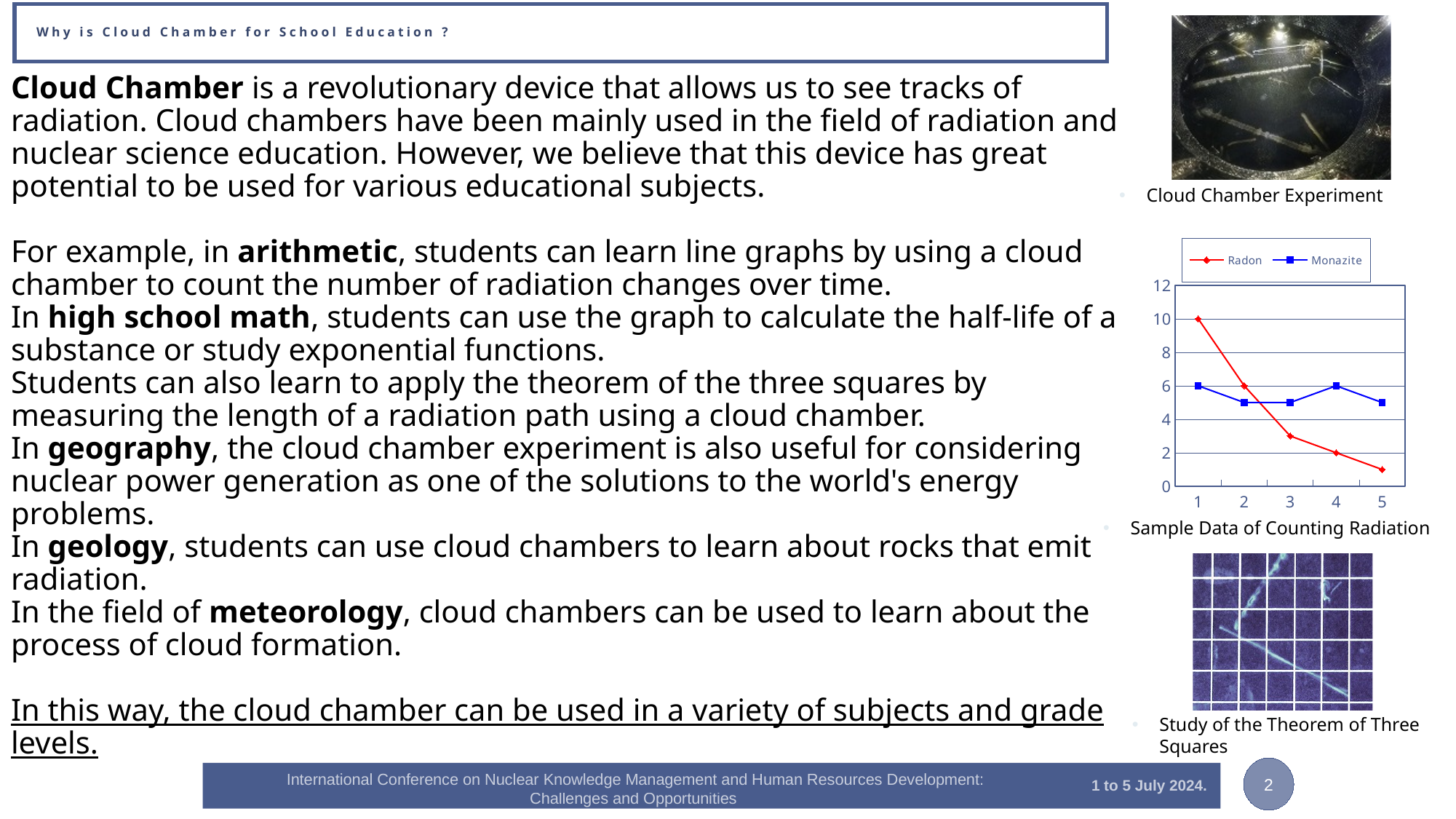
At x = 5, which series has the larger value, Radon or Monazite? Monazite Which two series are listed in the legend of the line chart? Radon and Monazite How many series does the legend of the line chart list? 2 How many points are plotted along the x axis for each series in the line chart? 5 What kind of chart is shown under the caption "Sample Data of Counting Radiation"? line chart Does the Radon series rise or fall as x increases from 1 to 5? fall At which x value does the Radon series reach its highest value? 1 What is the Monazite value at x = 4 in the line chart? 6 At x = 1, which series has the larger value, Radon or Monazite? Radon What is the Radon value at x = 1 in the line chart? 10 Is the Radon value at x = 5 greater or less than 2? less What is the Radon value at x = 2 in the line chart? 6